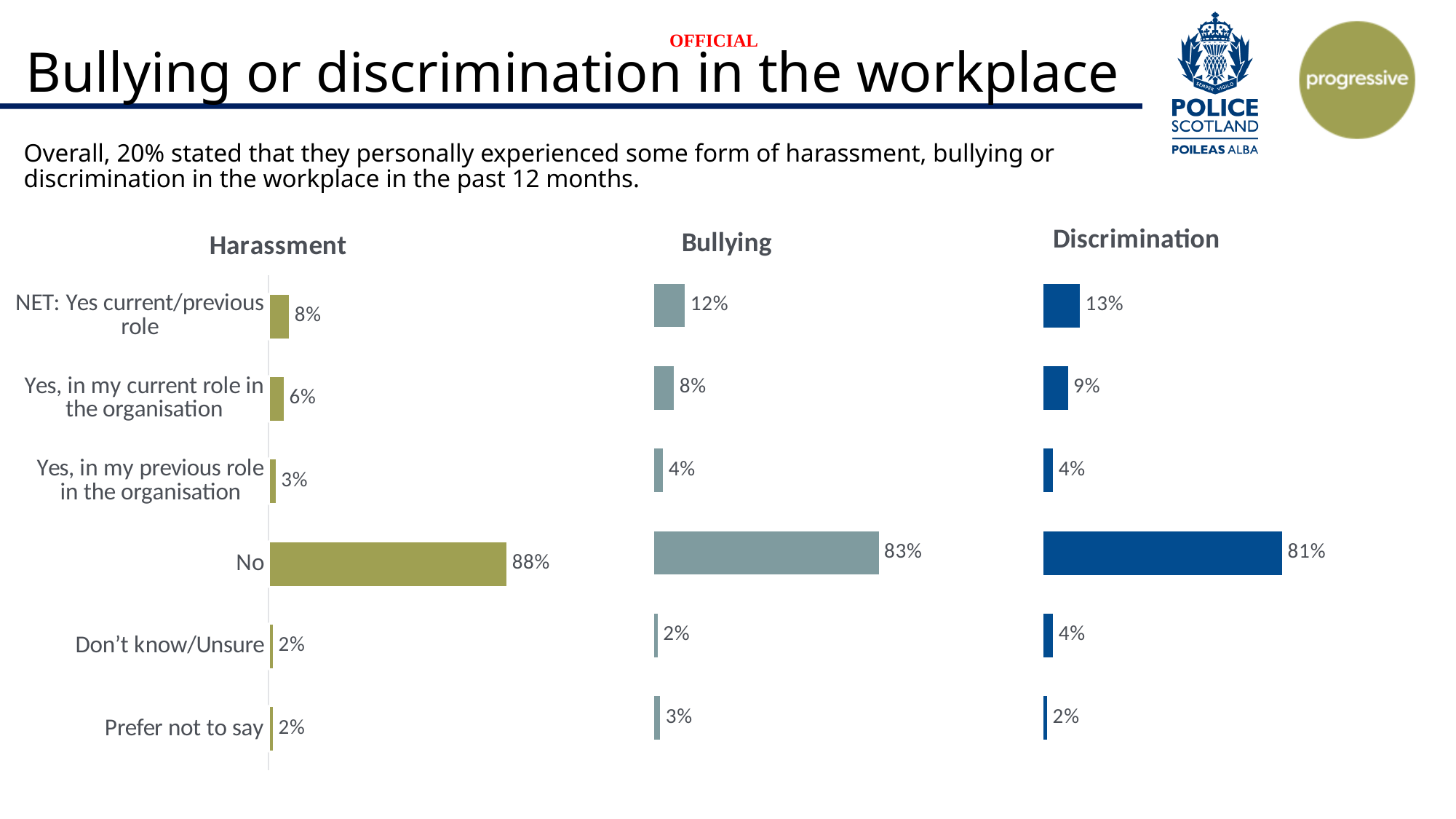
Which is larger: the "NET: Yes current/previous role" value in the Bullying chart or in the Discrimination chart? Discrimination In the Bullying chart, which category has the highest value? No How many charts are shown on the slide? 3 What kind of chart is the Discrimination chart? Bar chart In the Discrimination chart, what is the value for "Yes, in my current role in the organisation"? 9% How many categories are shown in the Harassment chart? 6 In the Bullying chart, what is the value for "NET: Yes current/previous role"? 12% In the Discrimination chart, what is the value for "Don't know/Unsure"? 4% In the Harassment chart, what is the difference between "No" and "NET: Yes current/previous role"? 80% What is the difference between the "No" value in the Harassment chart and the "No" value in the Discrimination chart? 7% In the Harassment chart, what is the value for "No"? 88% In the Bullying chart, which is larger: "Yes, in my current role in the organisation" or "Yes, in my previous role in the organisation"? Yes, in my current role in the organisation